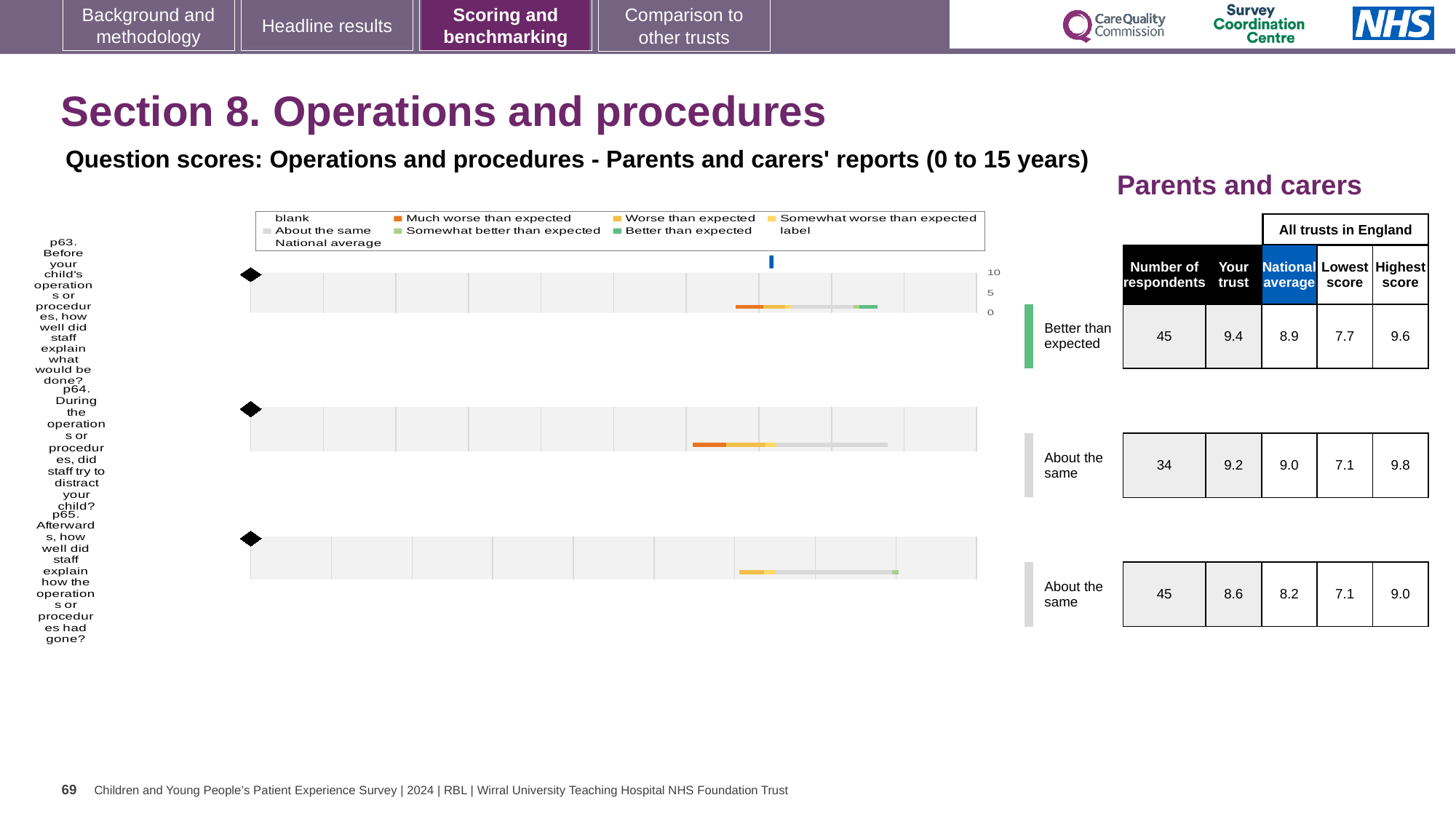
What is the lowest score among all trusts in England for question p64? 7.1 What type of chart is used to show the question scores on this slide? Bar chart What is the highest score among all trusts in England for question p65 (how well staff explained how the operation had gone)? 9.0 Which question has the lowest 'Your trust' score on this slide? p65 How many respondents answered question p64? 34 What is the difference between the 'Your trust' score and the national average for question p63? 0.5 What benchmark category is shown for question p63? Better than expected Which has the larger 'Your trust' score, question p63 or question p64? p63 Which question has the highest 'Highest score' value among all trusts in England? p64 What is the 'Your trust' score for question p63 (how well staff explained what would be done before the operation)? 9.4 How many survey questions are plotted on this slide? 3 What is the national average score for question p64 (did staff try to distract your child during the operation)? 9.0